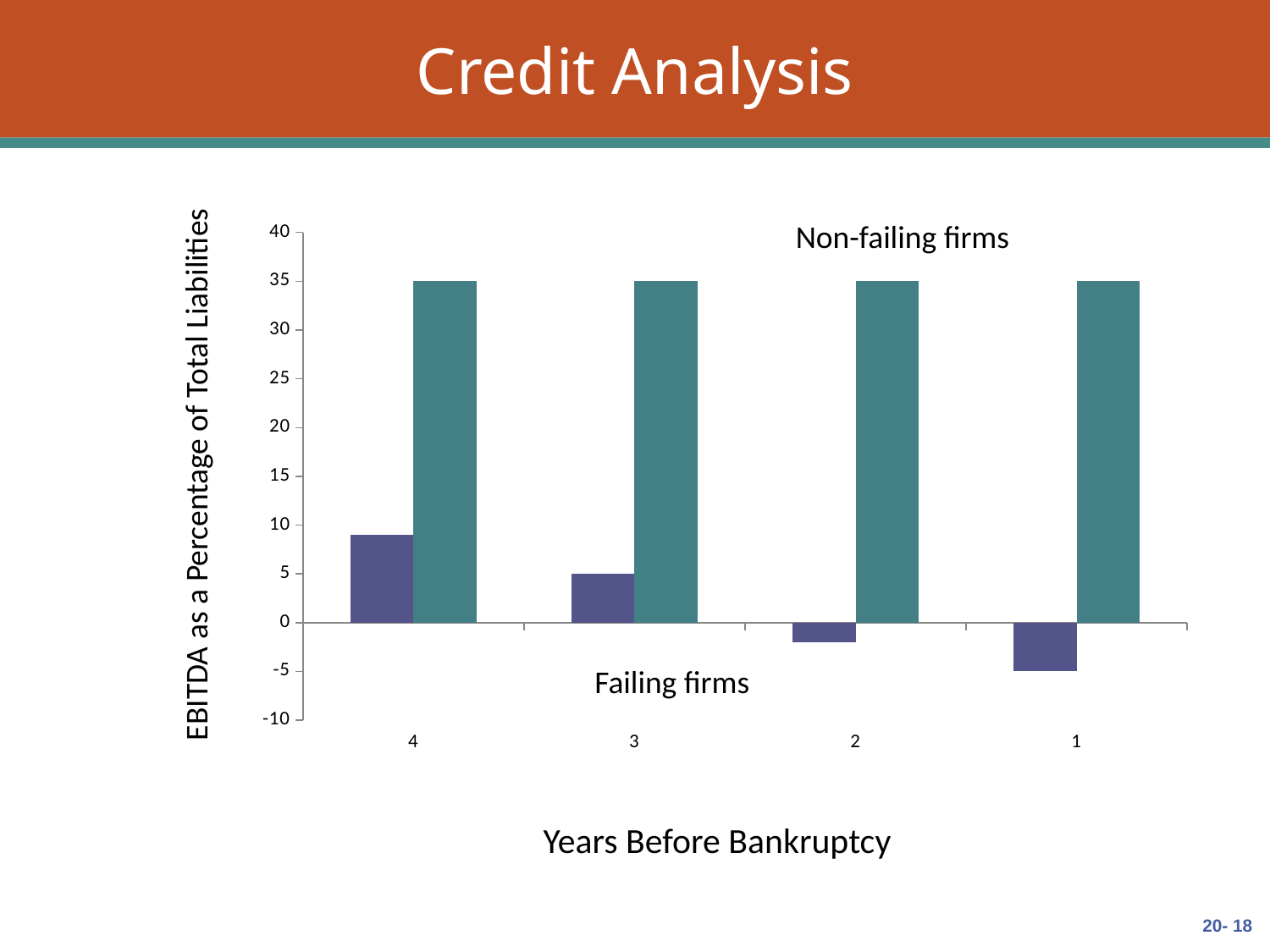
What is the title of the x axis? Years Before Bankruptcy What is the value for Failing firms at 1 year before bankruptcy? -5 How many series of bars does the chart show? 2 Which year before bankruptcy has the lowest value for Failing firms? 1 Do the values for Failing firms rise or fall moving along the x axis from 4 years to 1 year before bankruptcy? fall What is the value for Non-failing firms at 4 years before bankruptcy? 35 How many categories (years before bankruptcy) are shown on the x axis? 4 What is the value for Failing firms at 3 years before bankruptcy? 5 At 3 years before bankruptcy, what is the difference between the Non-failing firms value and the Failing firms value? 30 What kind of chart is shown on the slide? bar chart Is the value for Failing firms at 2 years before bankruptcy greater or less than 0? less Is the value for Failing firms at 4 years before bankruptcy greater or less than 10? less